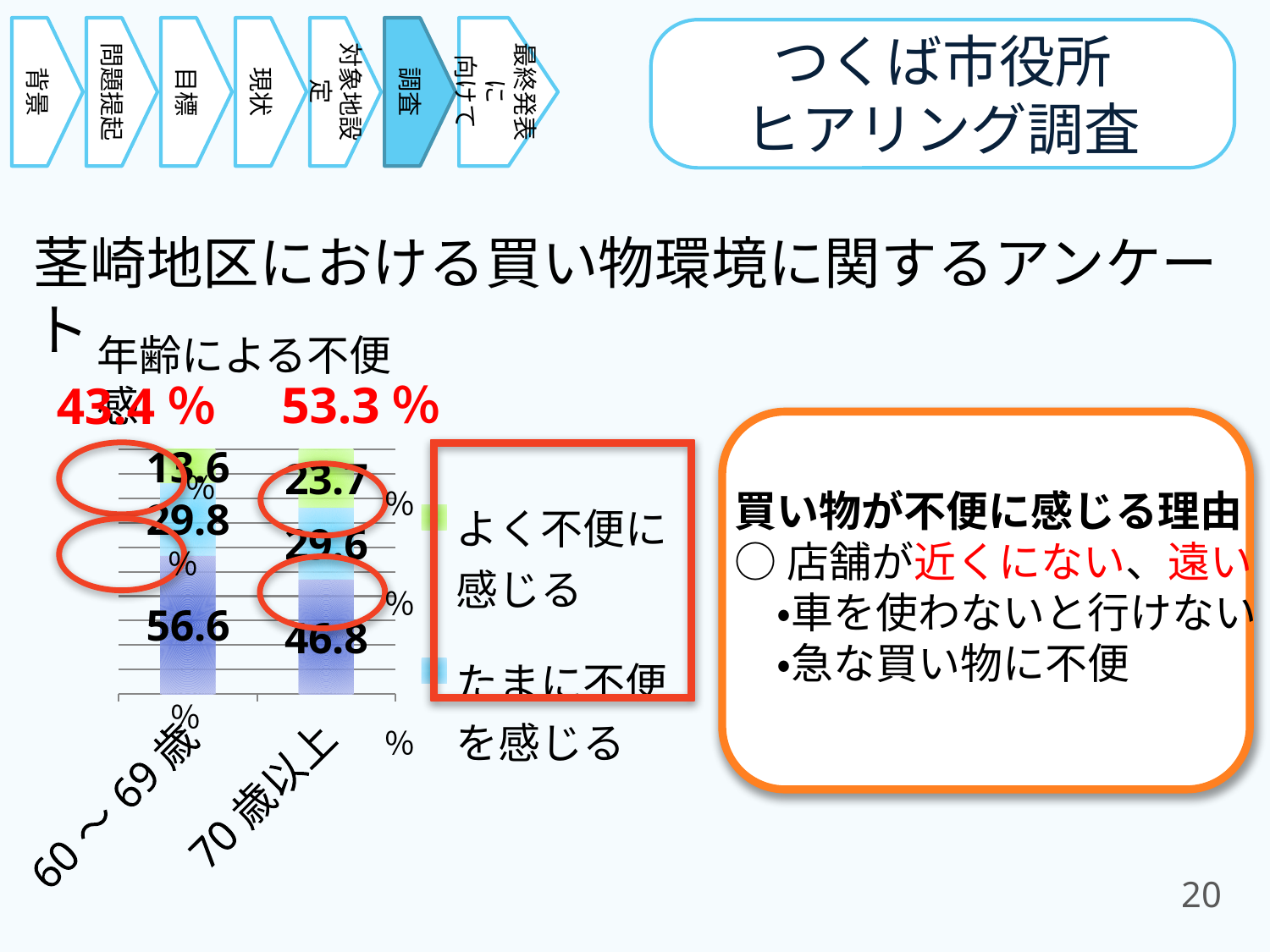
What is the value of the よく不便に感じる segment for 70歳以上? 23.7% What is the difference between the よく不便に感じる values for 70歳以上 and 60～69歳? 10.1% Which age group has the higher value for よく不便に感じる? 70歳以上 What is the value of the たまに不便を感じる segment for 70歳以上? 29.6% What red percentage is written above the 70歳以上 bar? 53.3% What is the difference between the two red percentages written above the bars (53.3% and 43.4%)? 9.9% What is the value of the bottom (largest) segment of the 70歳以上 bar? 46.8% What kind of chart is shown under the heading 年齢による不便感? stacked bar chart What is the value of the bottom (largest) segment of the 60～69歳 bar? 56.6% How many age categories are shown on the x axis of the chart? 2 What is the value of the たまに不便を感じる segment for 60～69歳? 29.8% What is the value of the よく不便に感じる segment for 60～69歳? 13.6%